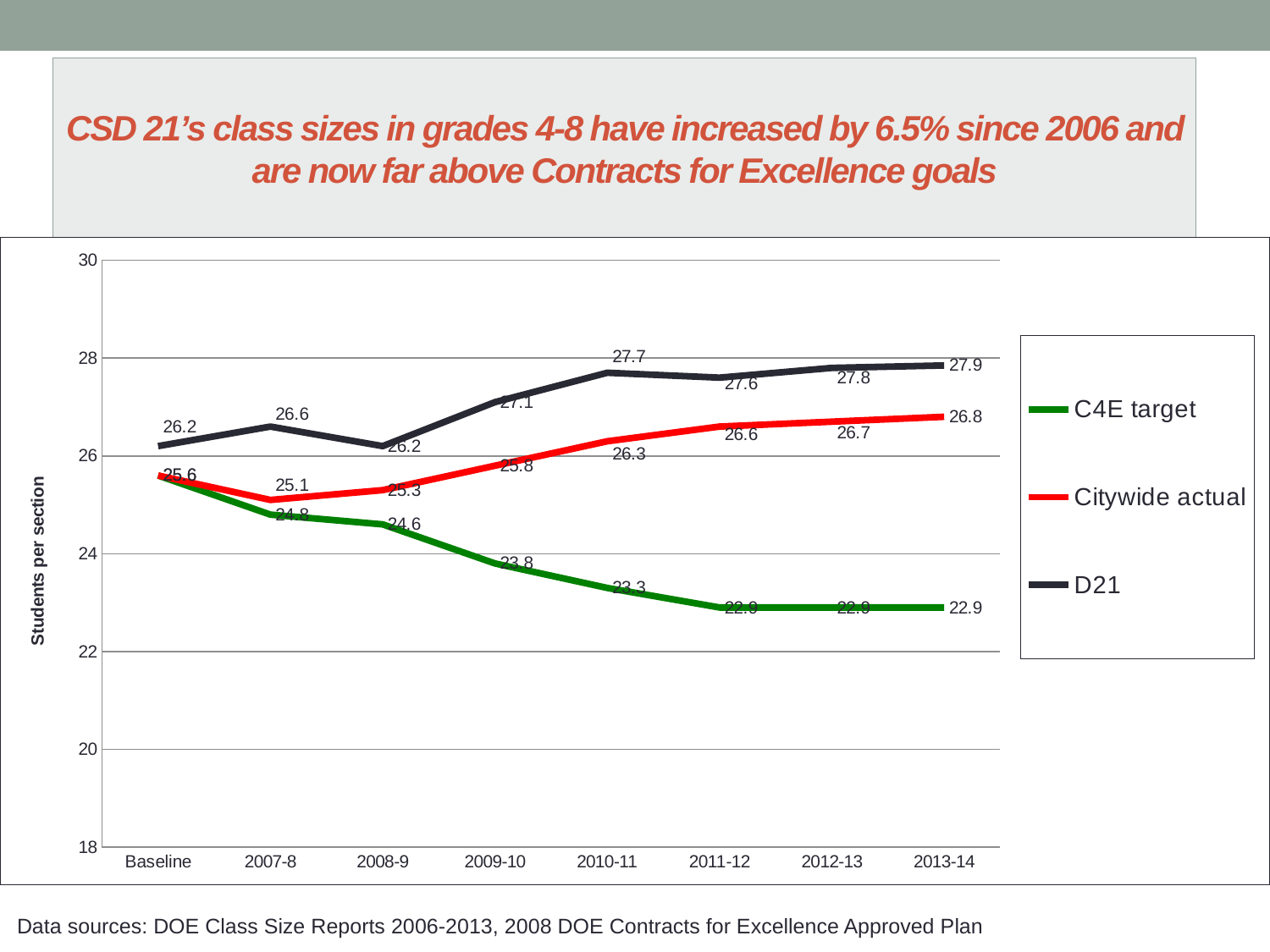
What kind of chart is shown on the slide? Line chart Does the C4E target series rise or fall from Baseline to 2013-14? Fall How many series does the legend list? 3 Which is larger, the D21 value for 2010-11 or for 2011-12? 2010-11 What is the D21 value at Baseline? 26.2 By how much did the D21 value increase from Baseline to 2013-14? 1.7 In which year is the Citywide actual series at its lowest value? 2007-8 What is the Citywide actual value for 2011-12? 26.6 In which year does the D21 series reach its highest value? 2013-14 What is the D21 value for 2013-14? 27.9 What is the difference between the D21 value and the Citywide actual value in 2013-14? 1.1 How many time points are shown on the x axis? 8